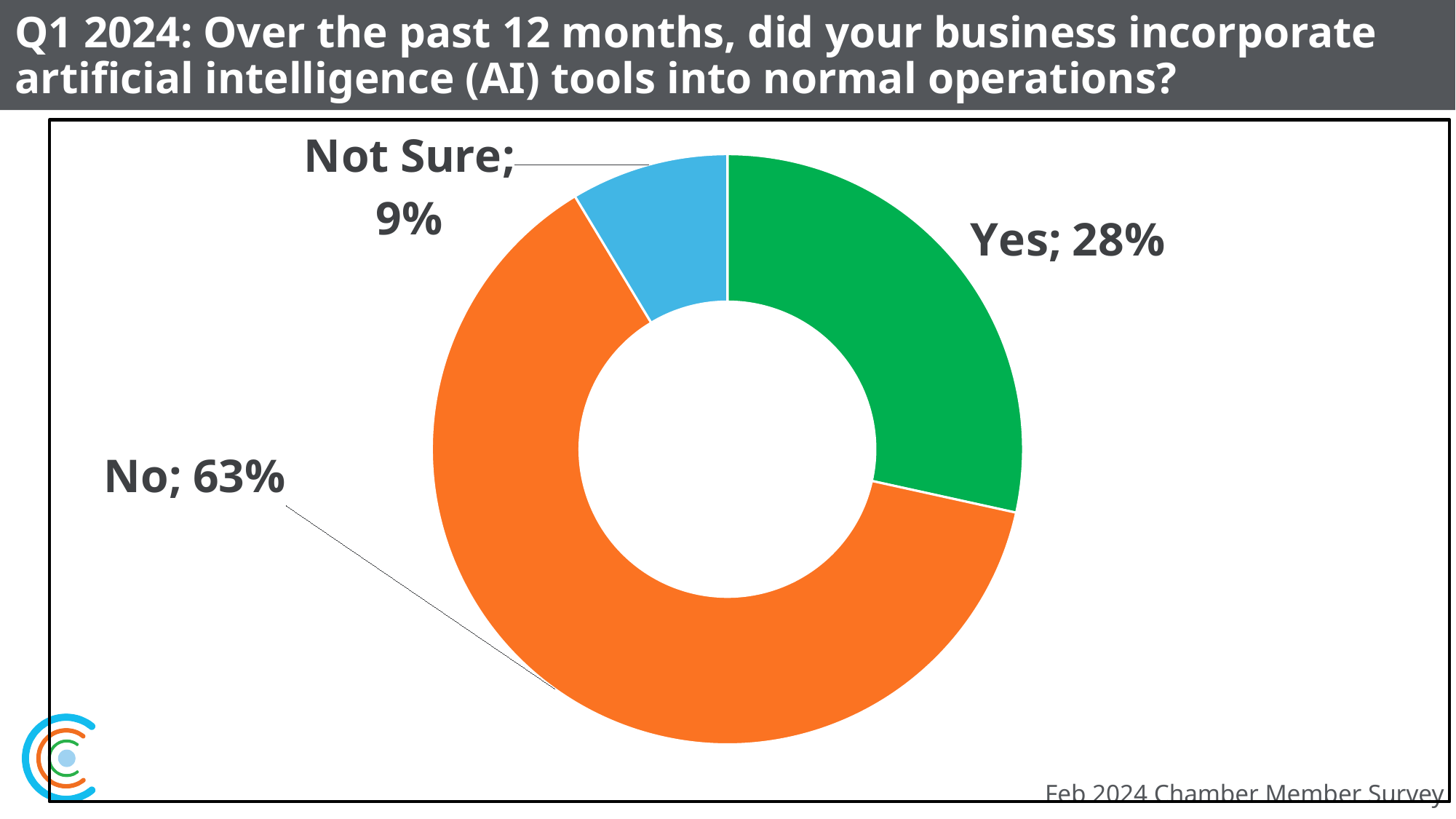
What percentage of respondents answered "Not Sure"? 9% What percentage of respondents answered "Yes"? 28% What is the difference in percentage points between the "No" and "Yes" responses? 35 Which is larger, the share for "Yes" or the share for "Not Sure"? Yes Which response has the smallest share of the chart? Not Sure What source is cited at the bottom right of the slide? Feb 2024 Chamber Member Survey How many response categories are shown in the chart? 3 What percentage of respondents answered "No"? 63% What is the difference in percentage points between the "Yes" and "Not Sure" responses? 19 What colour is the "No" segment of the chart? Orange Which response has the largest share of the chart? No What kind of chart is shown on the slide? Doughnut (pie) chart